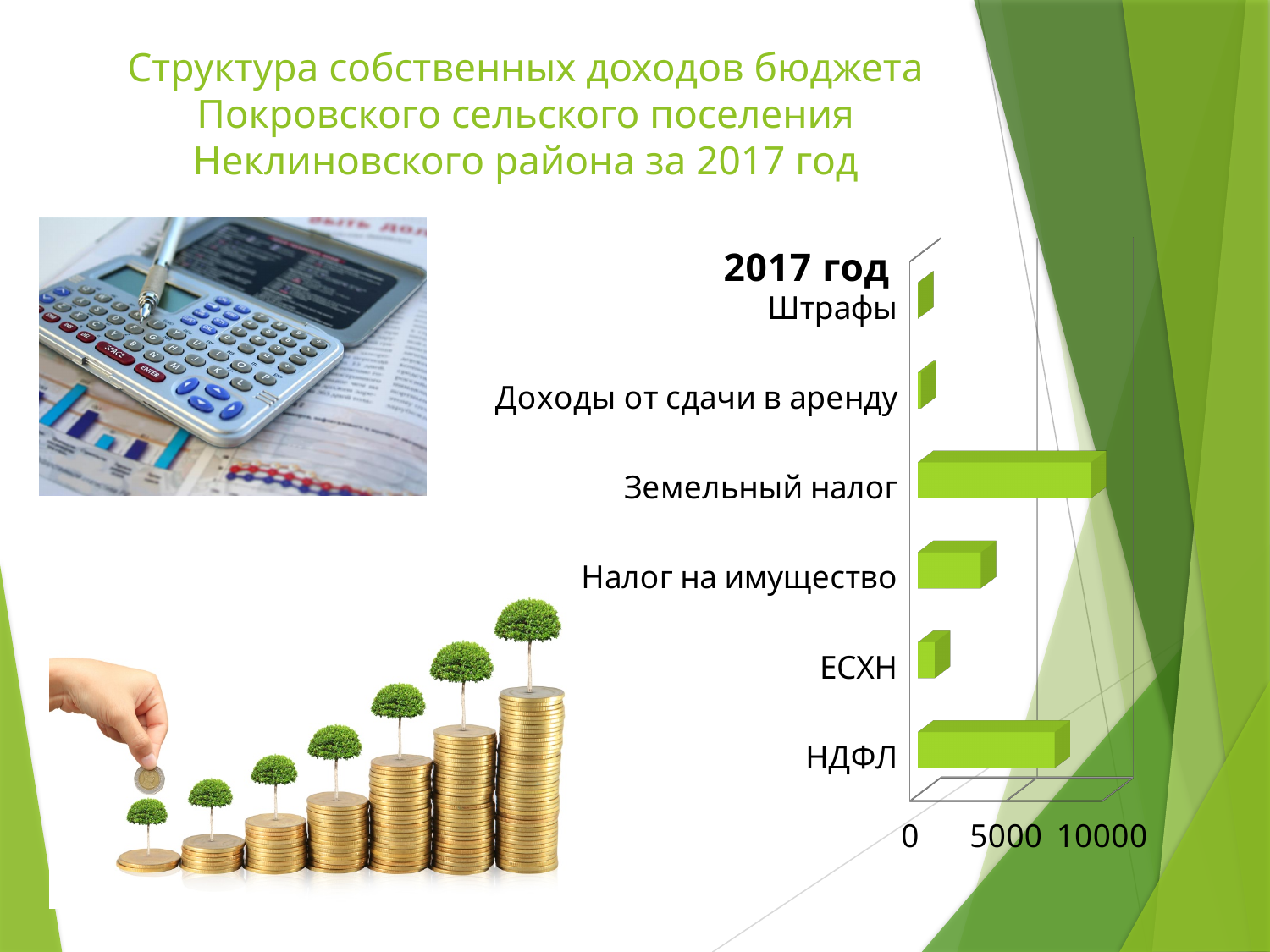
Which is larger, the value for Земельный налог or the value for НДФЛ? Земельный налог Is the value for Земельный налог greater or less than 5000? greater Is the value for Штрафы greater or less than 5000? less What kind of chart is shown on the slide? bar chart What is the title of the chart? 2017 год What is the highest tick value shown on the horizontal axis? 10000 Which category has the highest value in the chart? Земельный налог How many categories does the chart show? 6 Which is larger, the value for Налог на имущество or the value for ЕСХН? Налог на имущество Is the value for ЕСХН greater or less than 5000? less